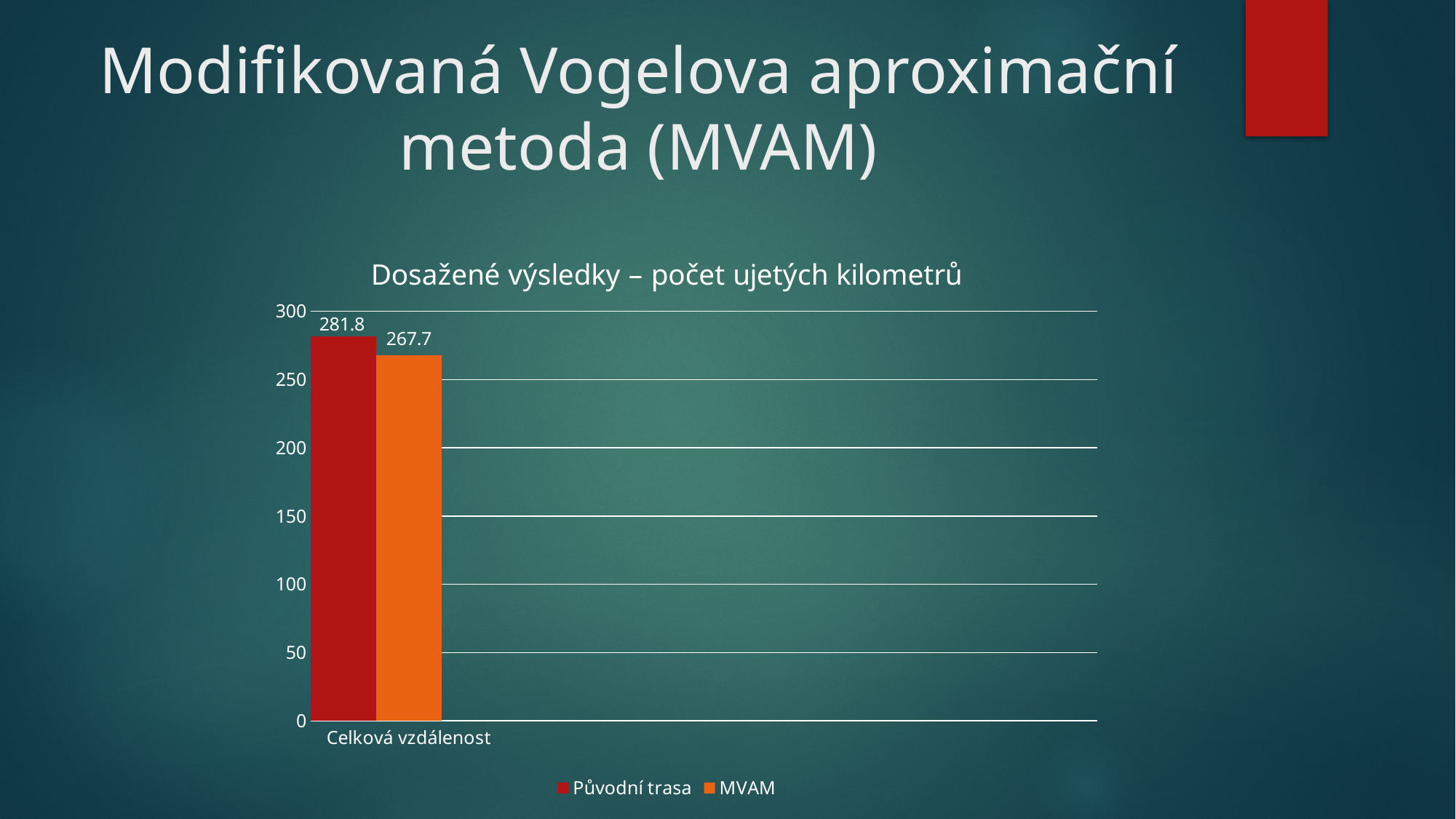
What is the value for MVAM in the chart? 267.7 What is the title of the chart? Dosažené výsledky – počet ujetých kilometrů What is the difference between the Původní trasa value and the MVAM value? 14.1 What is the value for Původní trasa in the chart? 281.8 How many categories are shown on the x axis? 1 Is the value for Původní trasa greater or less than 300? less Which series has the higher value, Původní trasa or MVAM? Původní trasa How many series does the legend list? 2 What kind of chart is shown on the slide? Bar chart Which series has the lowest value in the chart? MVAM Is the value for MVAM greater or less than 250? greater What is the label of the category on the x axis? Celková vzdálenost